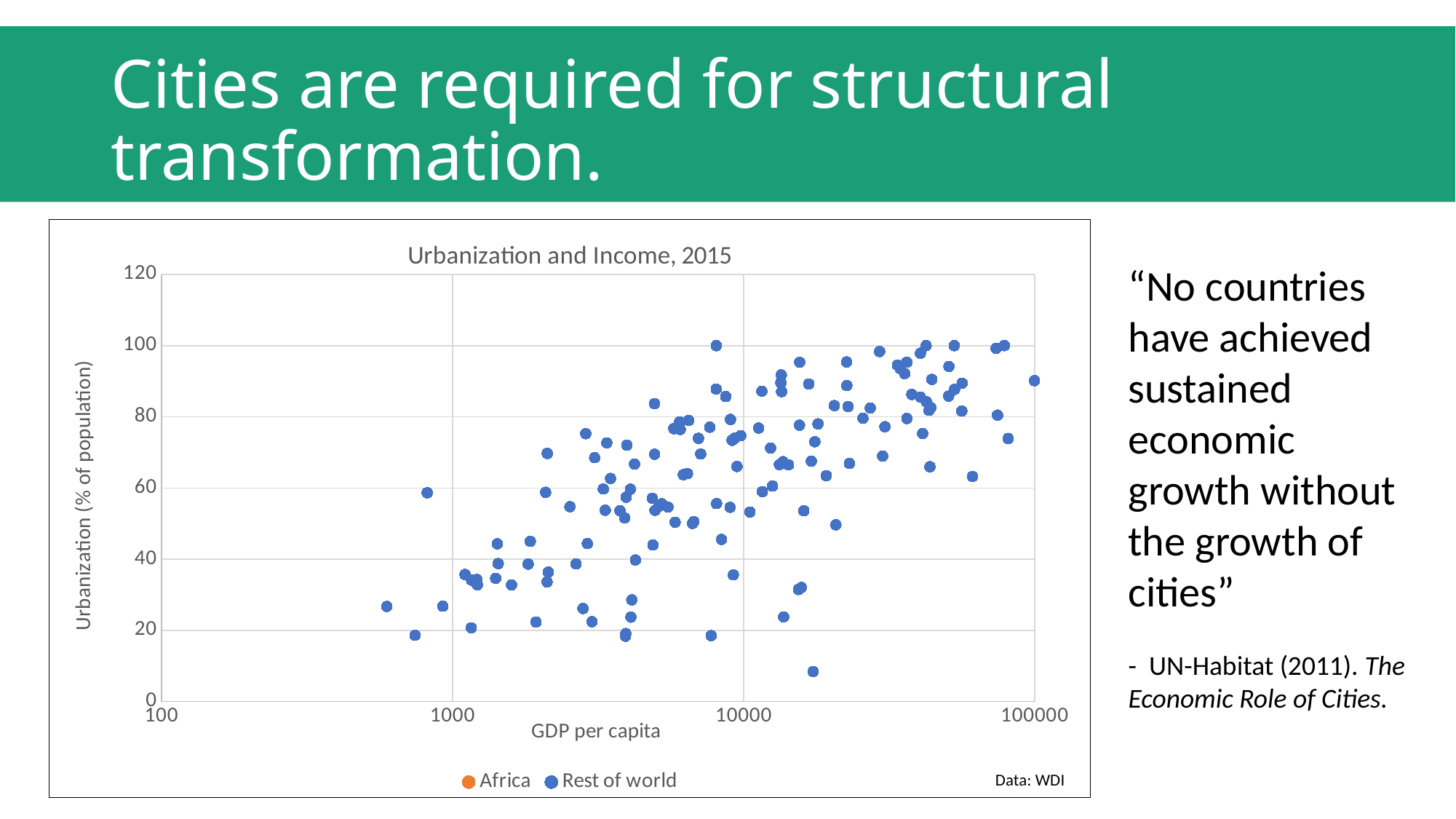
What kind of chart is shown on the slide? Scatter chart What are the two series named in the chart's legend? Africa and Rest of world What is the highest tick value shown on the x axis of the chart? 100000 What data source is cited in the bottom right corner of the chart? WDI How many series does the chart's legend list? 2 Do urbanization values generally rise or fall as GDP per capita increases along the x axis? Rise